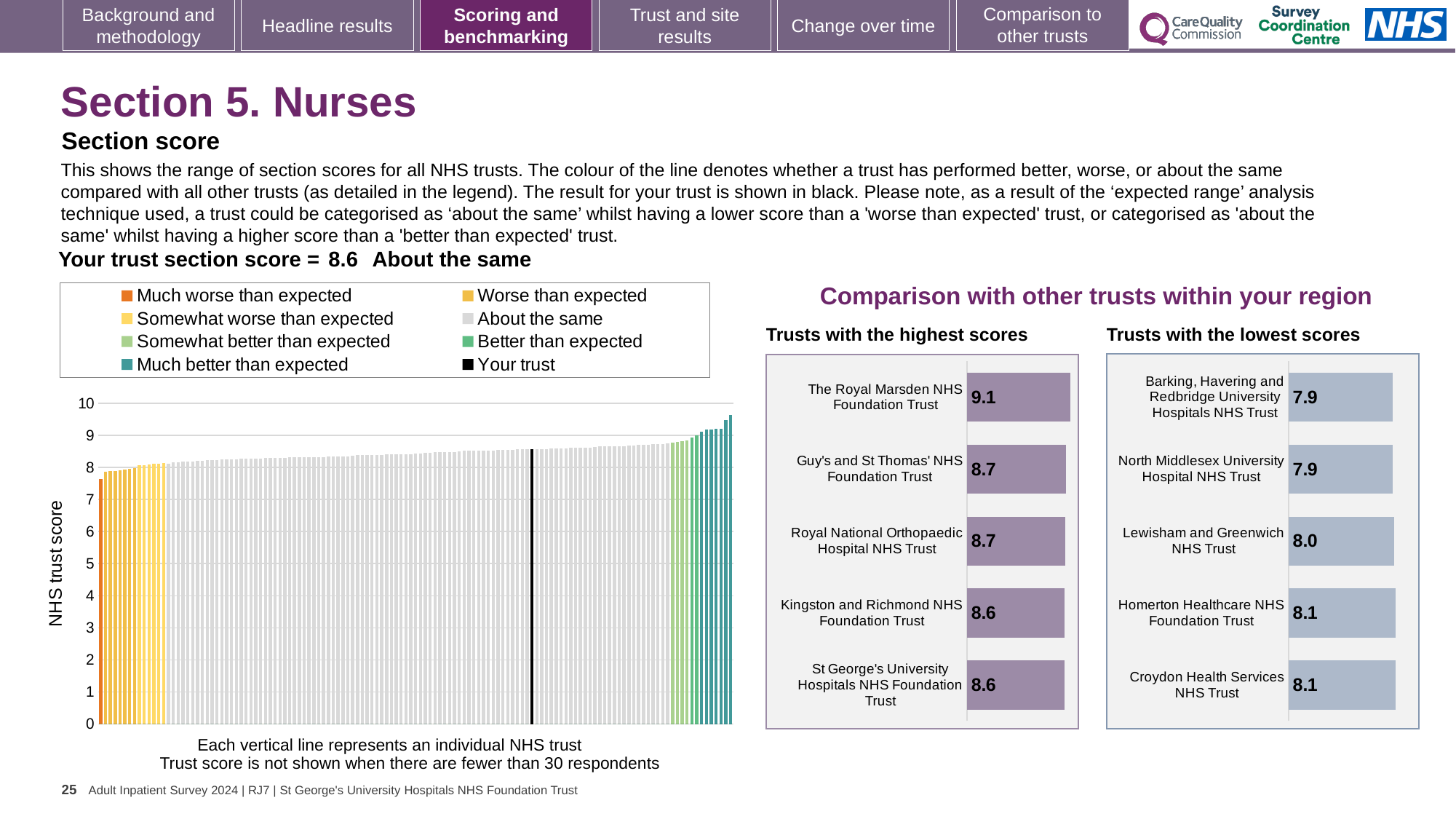
In the 'Trusts with the lowest scores' chart, what is the difference between the scores of Croydon Health Services NHS Trust and North Middlesex University Hospital NHS Trust? 0.2 What kind of chart is the 'NHS trust score' chart on the left of the slide? Bar chart How many entries does the legend of the 'NHS trust score' chart on the left list? 8 In the 'Trusts with the lowest scores' chart, what is the lowest score shown? 7.9 In the 'Trusts with the highest scores' chart, what is the difference between the scores of The Royal Marsden NHS Foundation Trust and Kingston and Richmond NHS Foundation Trust? 0.5 How many trusts are listed in the 'Trusts with the highest scores' chart? 5 In the 'NHS trust score' chart on the left, do the values rise or fall from left to right? Rise In the 'NHS trust score' chart on the left, is the value of the leftmost bar greater or less than 8? less In the 'Trusts with the lowest scores' chart, what is the score for Lewisham and Greenwich NHS Trust? 8.0 In the 'Trusts with the lowest scores' chart, which has the higher score: Homerton Healthcare NHS Foundation Trust or Lewisham and Greenwich NHS Trust? Homerton Healthcare NHS Foundation Trust In the 'Trusts with the highest scores' chart, what is the score for The Royal Marsden NHS Foundation Trust? 9.1 In the 'Trusts with the highest scores' chart, which trust has the highest score? The Royal Marsden NHS Foundation Trust